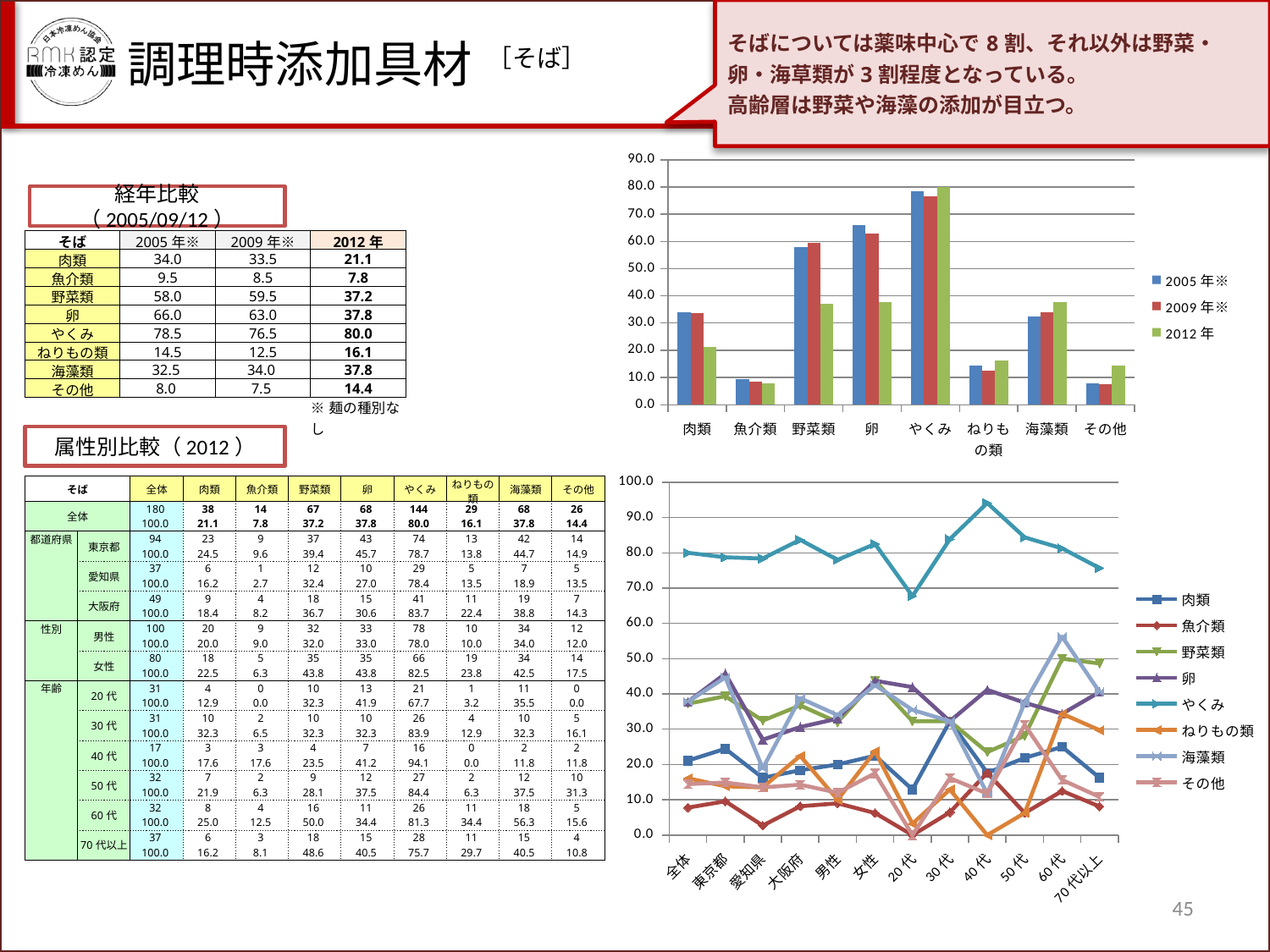
In the top-right bar chart, which category has the highest value for the 2012年 series? やくみ What kind of chart is the top-right chart on the slide? bar chart What kind of chart is the bottom-right chart on the slide? line chart How many categories are shown on the x axis of the top-right bar chart? 8 How many series does the legend of the bottom-right line chart list? 8 In the top-right bar chart, is the 2012年 value for 卵 greater or less than 50? less In the bottom-right line chart, at which category does the やくみ line reach its highest point? 40代 In the top-right bar chart, is the 2005年※ value for 野菜類 greater or less than 50? greater How many series does the legend of the top-right bar chart list? 3 How many categories are shown on the x axis of the bottom-right line chart? 12 In the top-right bar chart, which category has the lowest value for the 2012年 series? 魚介類 In the bottom-right line chart, is the やくみ value for 20代 greater or less than 70? less